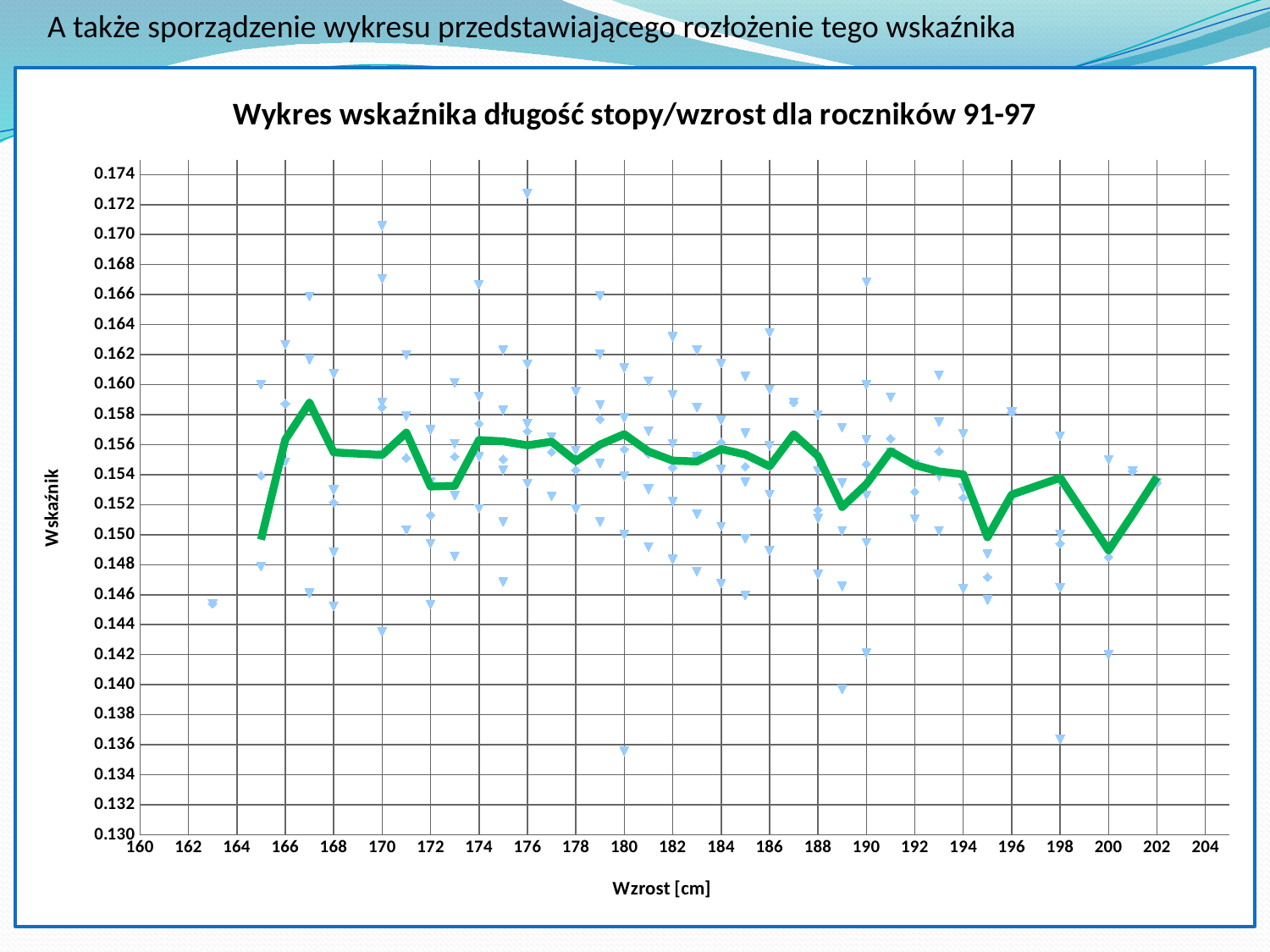
Is the value of the green line at height 172 greater or less than 0.154? less What is the title of the chart? Wykres wskaźnika długość stopy/wzrost dla roczników 91-97 What is the label of the x axis? Wzrost [cm] Is the value of the green line at height 180 greater or less than 0.154? greater Is the value of the green line at height 200 greater or less than 0.150? less At which height does the green line reach its highest value? 167 What kind of chart is shown on the slide? scatter chart with a line Which is larger: the green line value at height 167 or at height 200? 167 Does the green line rise or fall between height 187 and height 189? fall At which height is the highest individual scatter point located? 176